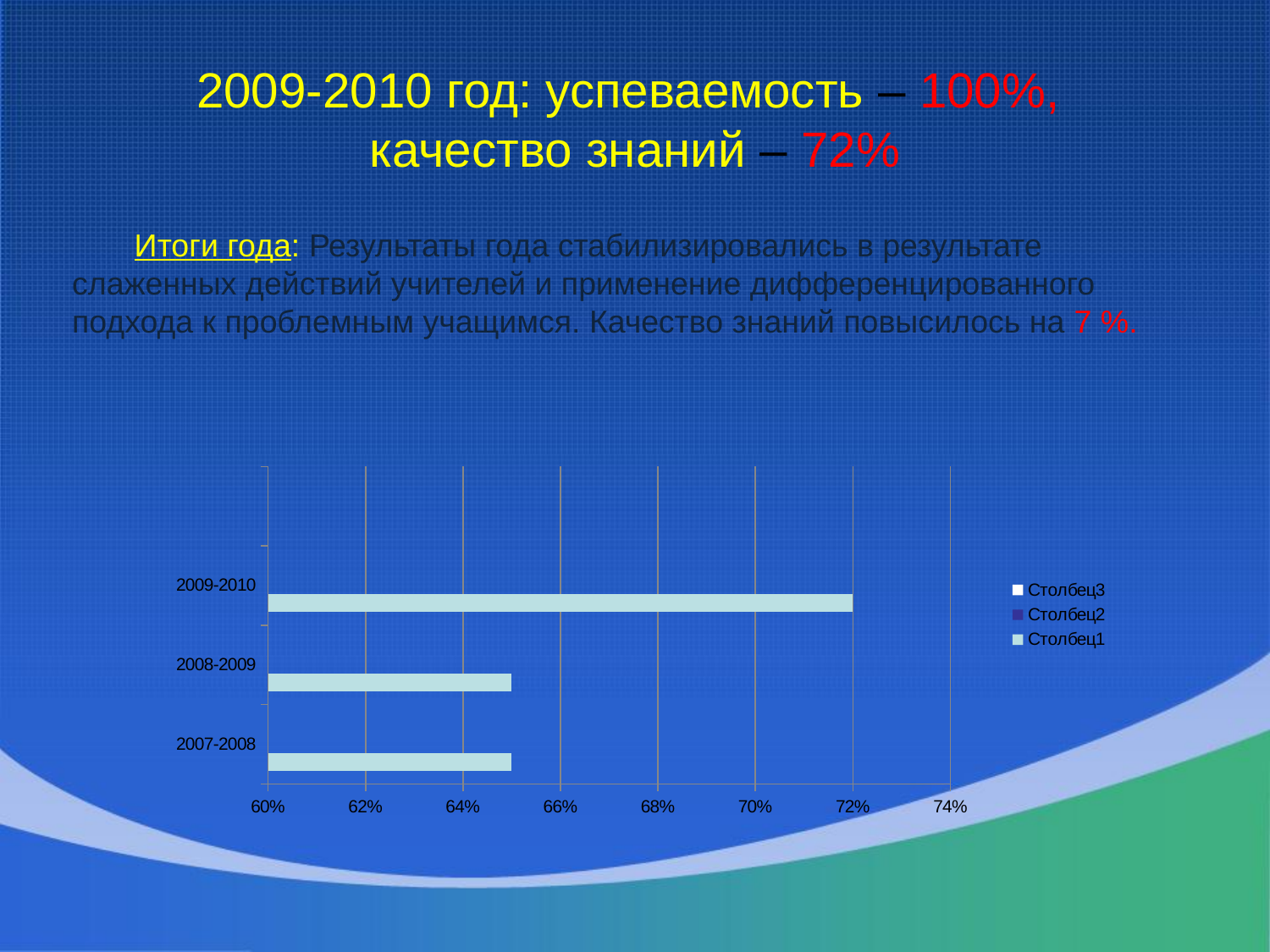
Which is larger, the value for 2009-2010 or the value for 2007-2008? 2009-2010 What is the name of the first legend entry listed at the top of the legend? Столбец3 Is the value for 2008-2009 greater or less than 64%? greater Is the value for 2008-2009 greater or less than 66%? less Is the value for 2009-2010 greater or less than 70%? greater What is the value for 2009-2010 on the chart? 72% What kind of chart is shown on the slide? bar chart How many series does the chart legend list? 3 Which school year has the highest value on the chart? 2009-2010 What is the lowest value shown on the chart's horizontal axis? 60% How many categories (school years) are shown on the chart? 3